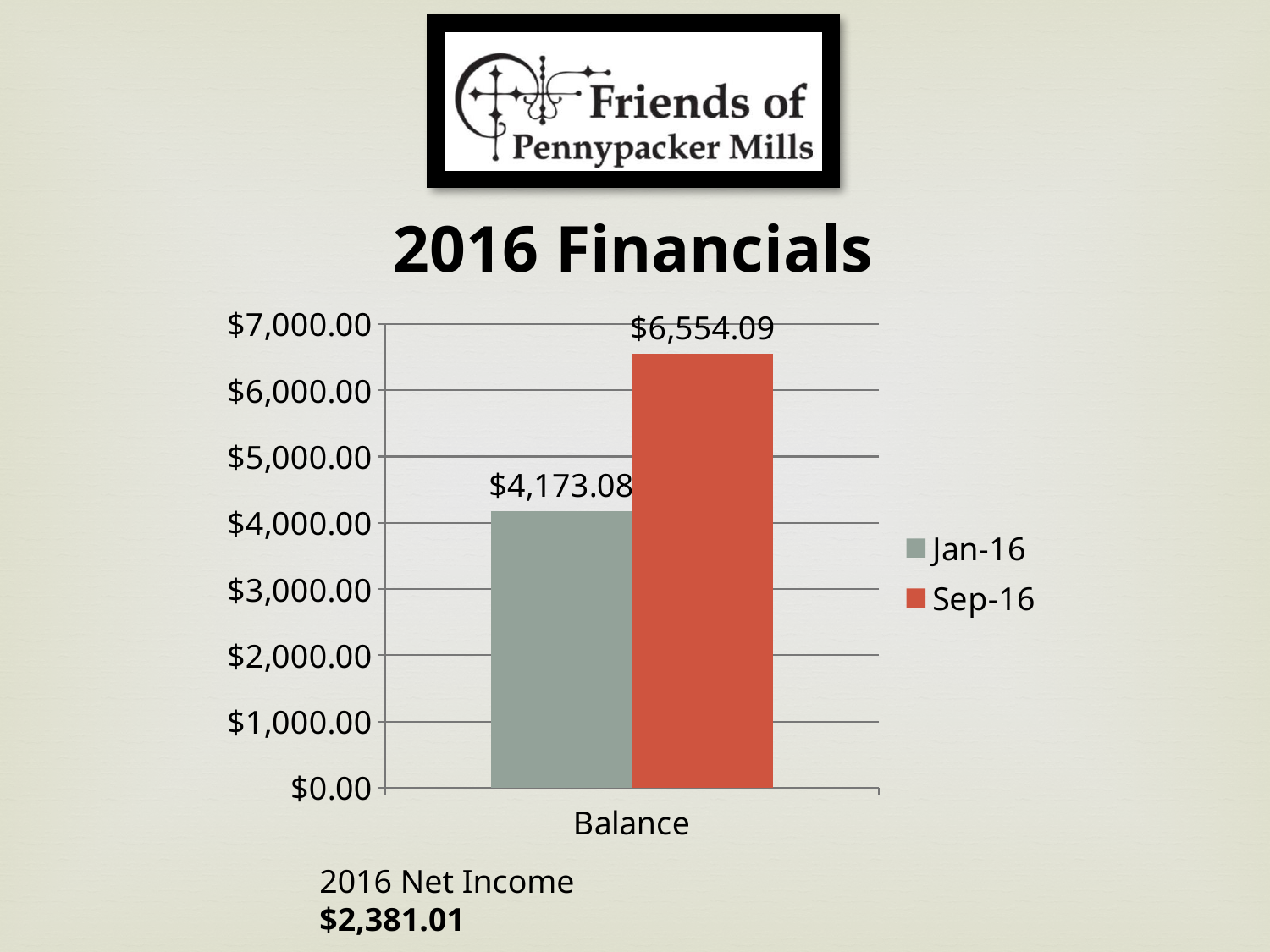
Which series shows the lowest balance? Jan-16 Is the Jan-16 balance greater or less than $5,000.00? less Which series has the higher balance, Jan-16 or Sep-16? Sep-16 What kind of chart is shown on the slide? bar chart How many categories are shown on the x axis? 1 How many series does the legend list? 2 What is the label of the category on the x axis? Balance What is the Sep-16 balance shown on the chart? $6,554.09 What colour is the Sep-16 bar? red Is the Sep-16 balance greater or less than $6,000.00? greater What is the Jan-16 balance shown on the chart? $4,173.08 What is the difference between the Sep-16 and Jan-16 balances? $2,381.01